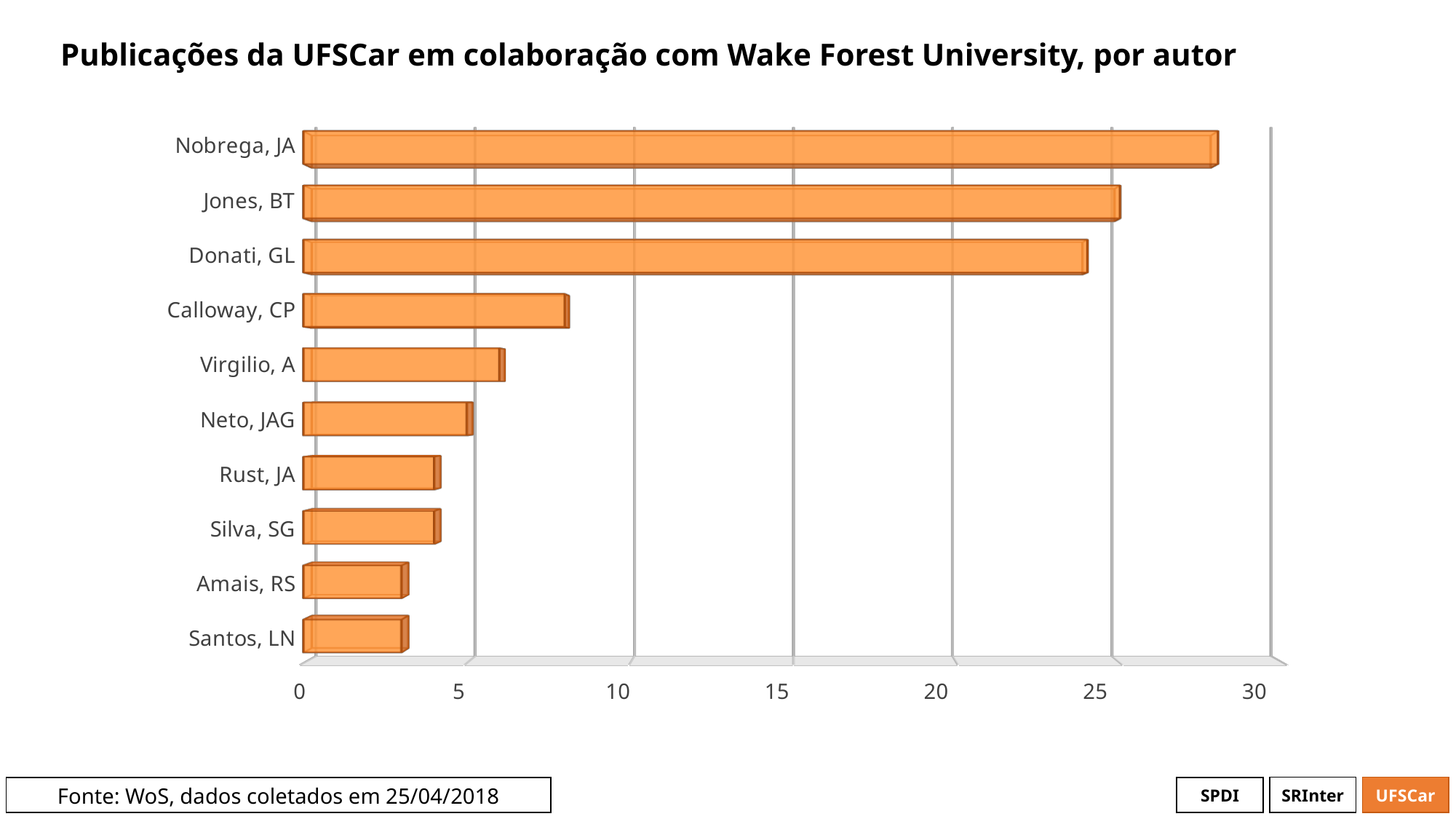
Is the value for Amais, RS greater or less than 5? less Is the value for Calloway, CP greater or less than 10? less What colour are the bars in the chart? orange Which author has the highest number of publications? Nobrega, JA How many authors are shown in the chart? 10 Which has more publications, Calloway, CP or Virgilio, A? Calloway, CP Which has more publications, Nobrega, JA or Donati, GL? Nobrega, JA What kind of chart is shown on the slide? bar chart Is the value for Nobrega, JA greater or less than 25? greater What is the title of the chart? Publicações da UFSCar em colaboração com Wake Forest University, por autor